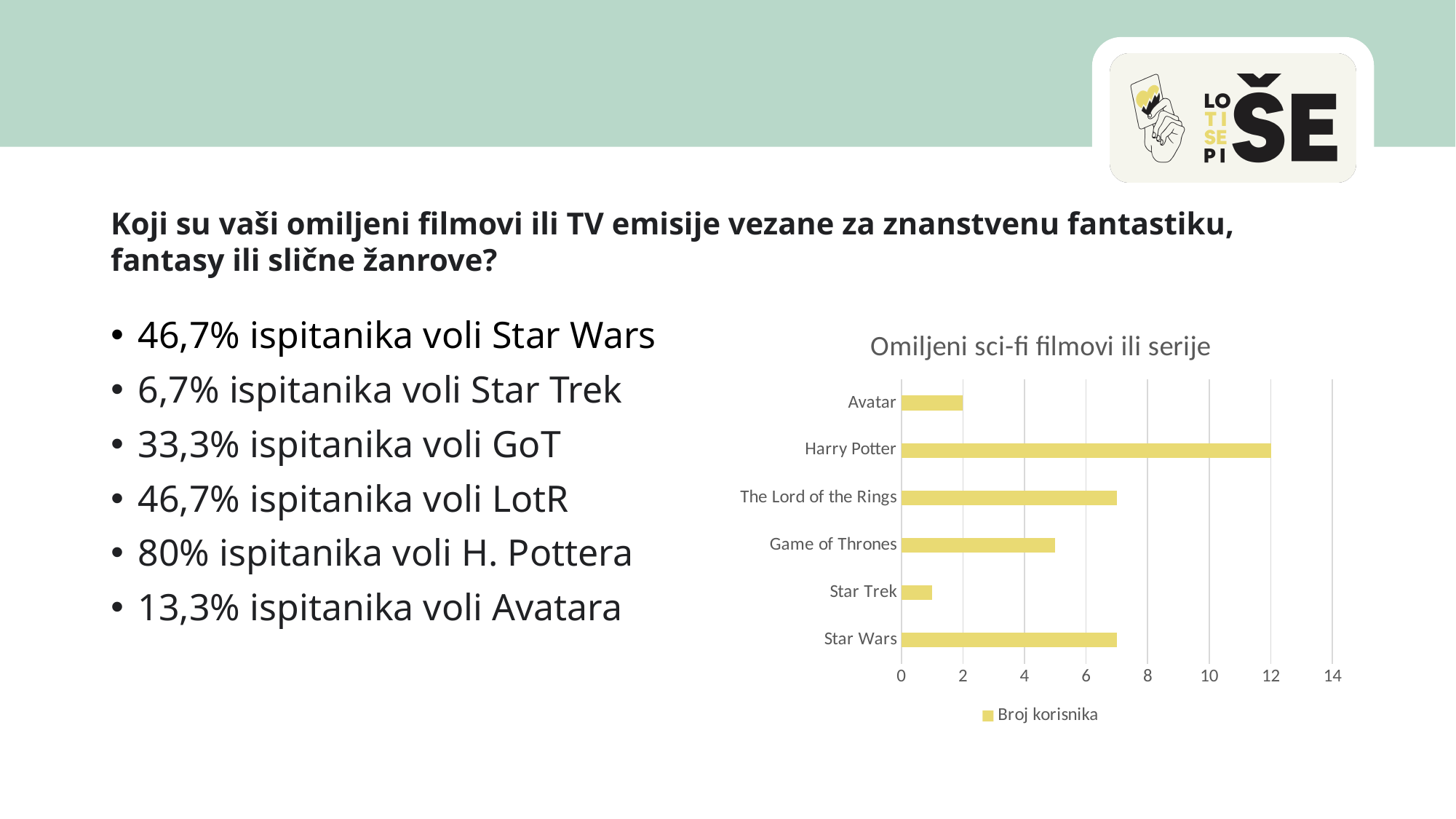
Which has a larger value, Game of Thrones or Star Trek? Game of Thrones What is the difference between the values for Harry Potter and Avatar? 10 How many categories are shown in the chart? 6 What kind of chart is shown on the slide? Bar chart Which category has the highest value in the chart? Harry Potter Is the value for The Lord of the Rings greater or less than 6? greater What is the value for Avatar in the chart? 2 Is the value for Star Wars greater or less than 8? less What is the value for Harry Potter in the chart? 12 Which category has the lowest value in the chart? Star Trek How many series does the legend list? 1 Is the value for Game of Thrones greater or less than 6? less